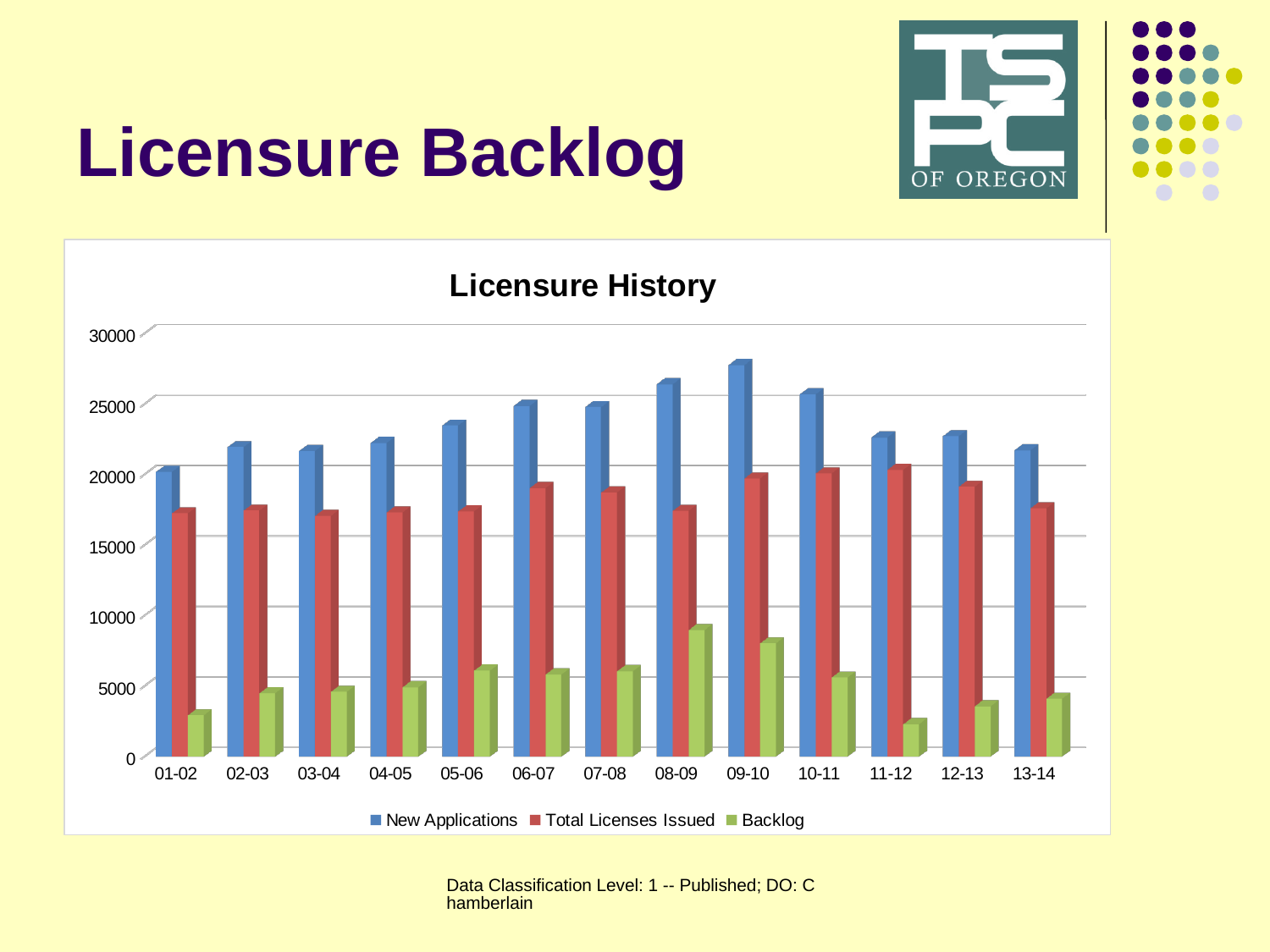
Is the Total Licenses Issued value for 01-02 greater or less than 20000? less How many series does the legend list? 3 In which year is the Backlog value lowest? 11-12 What kind of chart is shown on the slide? Bar chart Is the New Applications value for 09-10 greater or less than 25000? greater Is the Backlog value for 08-09 greater or less than 10000? less In which year is the New Applications value highest? 09-10 What is the title of the chart? Licensure History In which year is the Backlog value highest? 08-09 In 09-10, which is larger: New Applications or Total Licenses Issued? New Applications How many year categories are shown on the x axis? 13 Does the Backlog value rise or fall from 08-09 to 11-12? Fall